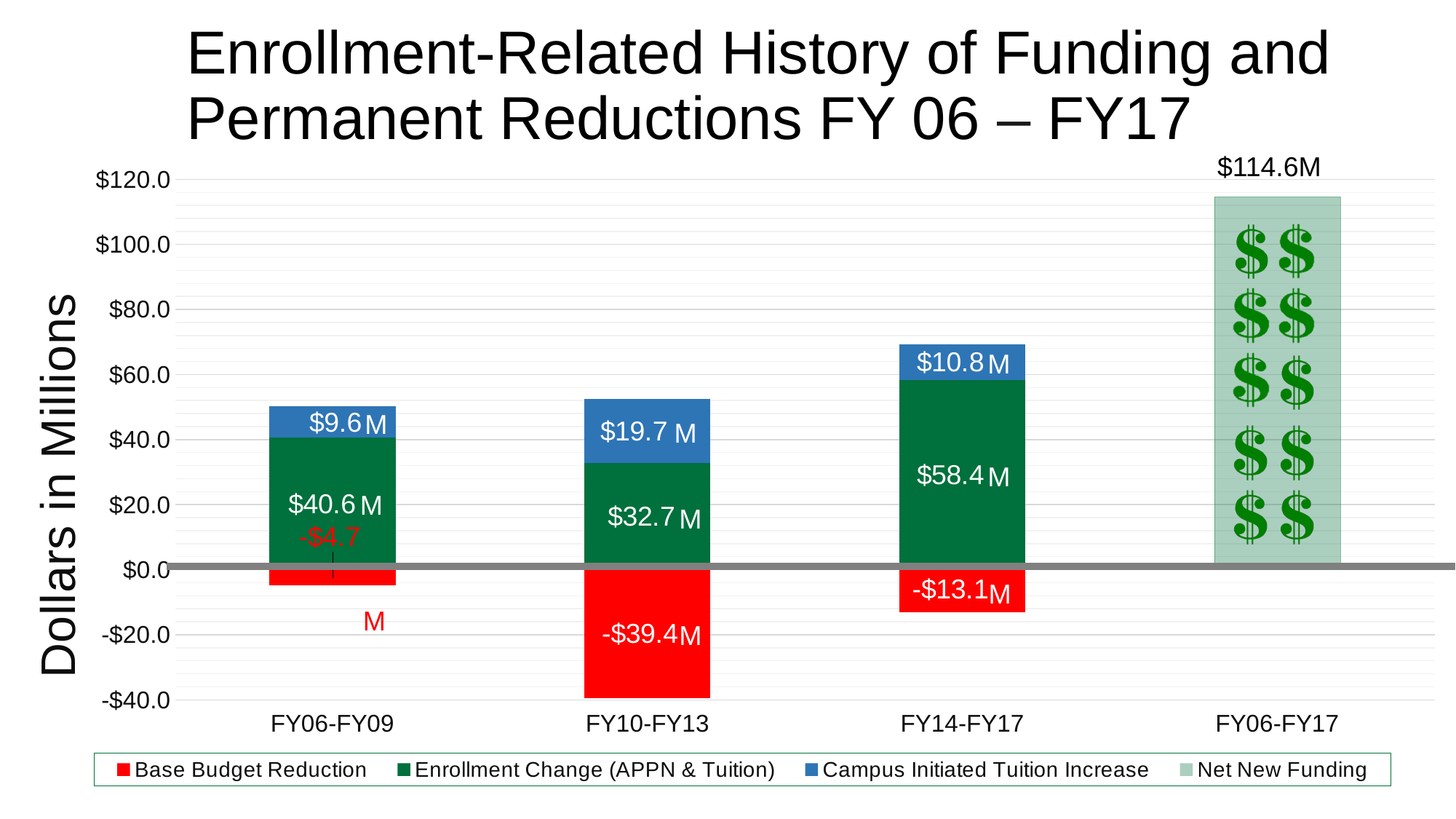
Which period has the lowest (most negative) Base Budget Reduction value? FY10-FY13 How many periods are shown on the x axis? 4 Which is larger: the Enrollment Change (APPN & Tuition) for FY06-FY09 or for FY10-FY13? FY06-FY09 Is the Net New Funding value for FY06-FY17 greater or less than $100.0? greater What is the Net New Funding value shown for FY06-FY17? $114.6M Which period has the highest Enrollment Change (APPN & Tuition) value? FY14-FY17 How many series does the legend list? 4 What is the total of the positive segments (Enrollment Change and Campus Initiated Tuition Increase) for FY14-FY17? $69.2M What is the Campus Initiated Tuition Increase value for FY06-FY09? $9.6M What is the Base Budget Reduction value for FY10-FY13? -$39.4M What is the value of Enrollment Change (APPN & Tuition) for FY14-FY17? $58.4M What is the difference between the Campus Initiated Tuition Increase for FY10-FY13 and for FY14-FY17? $8.9M